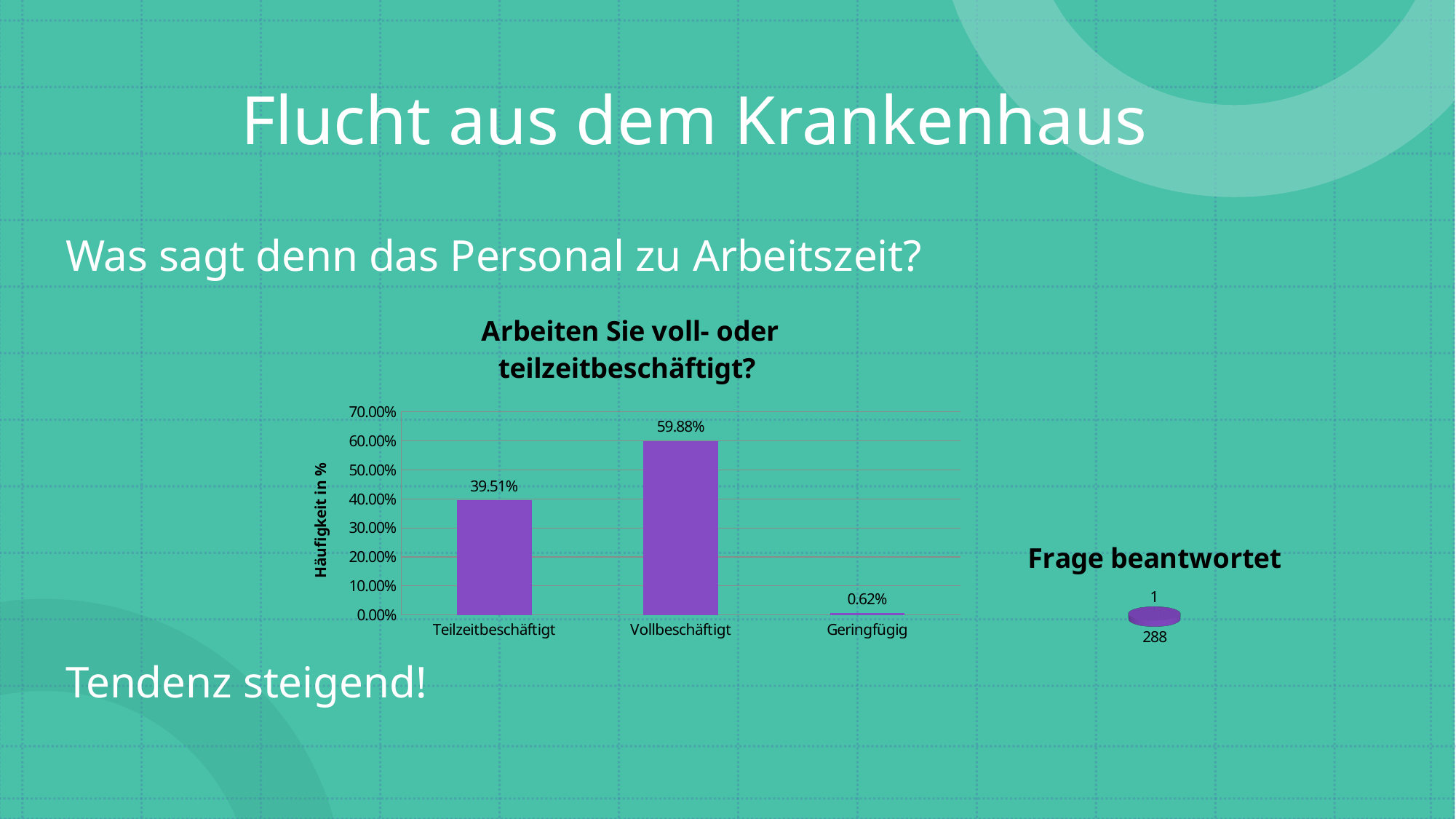
In the bar chart 'Arbeiten Sie voll- oder teilzeitbeschäftigt?', which category has the highest value? Vollbeschäftigt In the bar chart 'Arbeiten Sie voll- oder teilzeitbeschäftigt?', what is the value for Teilzeitbeschäftigt? 39.51% In the bar chart 'Arbeiten Sie voll- oder teilzeitbeschäftigt?', what is the value for Vollbeschäftigt? 59.88% What is the y-axis label of the bar chart 'Arbeiten Sie voll- oder teilzeitbeschäftigt?'? Häufigkeit in % How many categories are shown in the bar chart 'Arbeiten Sie voll- oder teilzeitbeschäftigt?'? 3 In the bar chart 'Arbeiten Sie voll- oder teilzeitbeschäftigt?', what is the value for Geringfügig? 0.62% In the bar chart 'Arbeiten Sie voll- oder teilzeitbeschäftigt?', which is larger: Teilzeitbeschäftigt or Vollbeschäftigt? Vollbeschäftigt In the bar chart 'Arbeiten Sie voll- oder teilzeitbeschäftigt?', which category has the lowest value? Geringfügig In the bar chart 'Arbeiten Sie voll- oder teilzeitbeschäftigt?', what is the difference between the values for Vollbeschäftigt and Teilzeitbeschäftigt? 20.37% What kind of chart is the chart titled 'Arbeiten Sie voll- oder teilzeitbeschäftigt?'? bar chart What is the title of the small chart on the right side of the slide? Frage beantwortet In the bar chart 'Arbeiten Sie voll- oder teilzeitbeschäftigt?', is the value for Teilzeitbeschäftigt greater or less than 50.00%? less